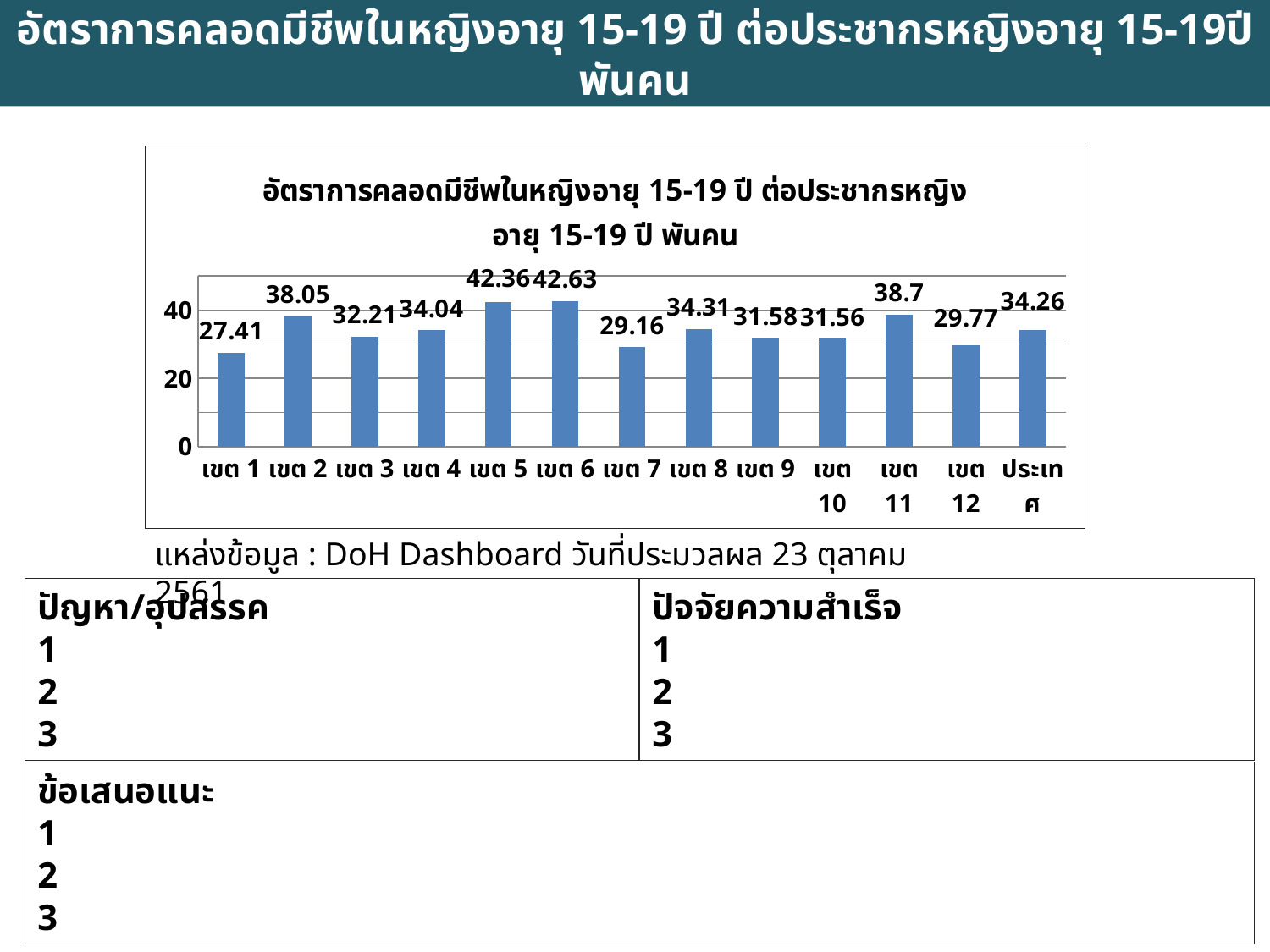
Which category has the lowest value? เขต 1 What is the difference between the values for เขต 6 and เขต 1? 15.22 What kind of chart is shown on the slide? bar chart What is the value for เขต 11? 38.7 How many categories are shown on the x axis? 13 What is the value for เขต 1? 27.41 Which is larger, the value for เขต 4 or the value for เขต 7? เขต 4 Is the value for เขต 5 greater or less than 40? greater What is the value for ประเทศ? 34.26 Which category has the highest value? เขต 6 What is the difference between the values for เขต 2 and เขต 3? 5.84 What is the highest tick value shown on the y axis? 40